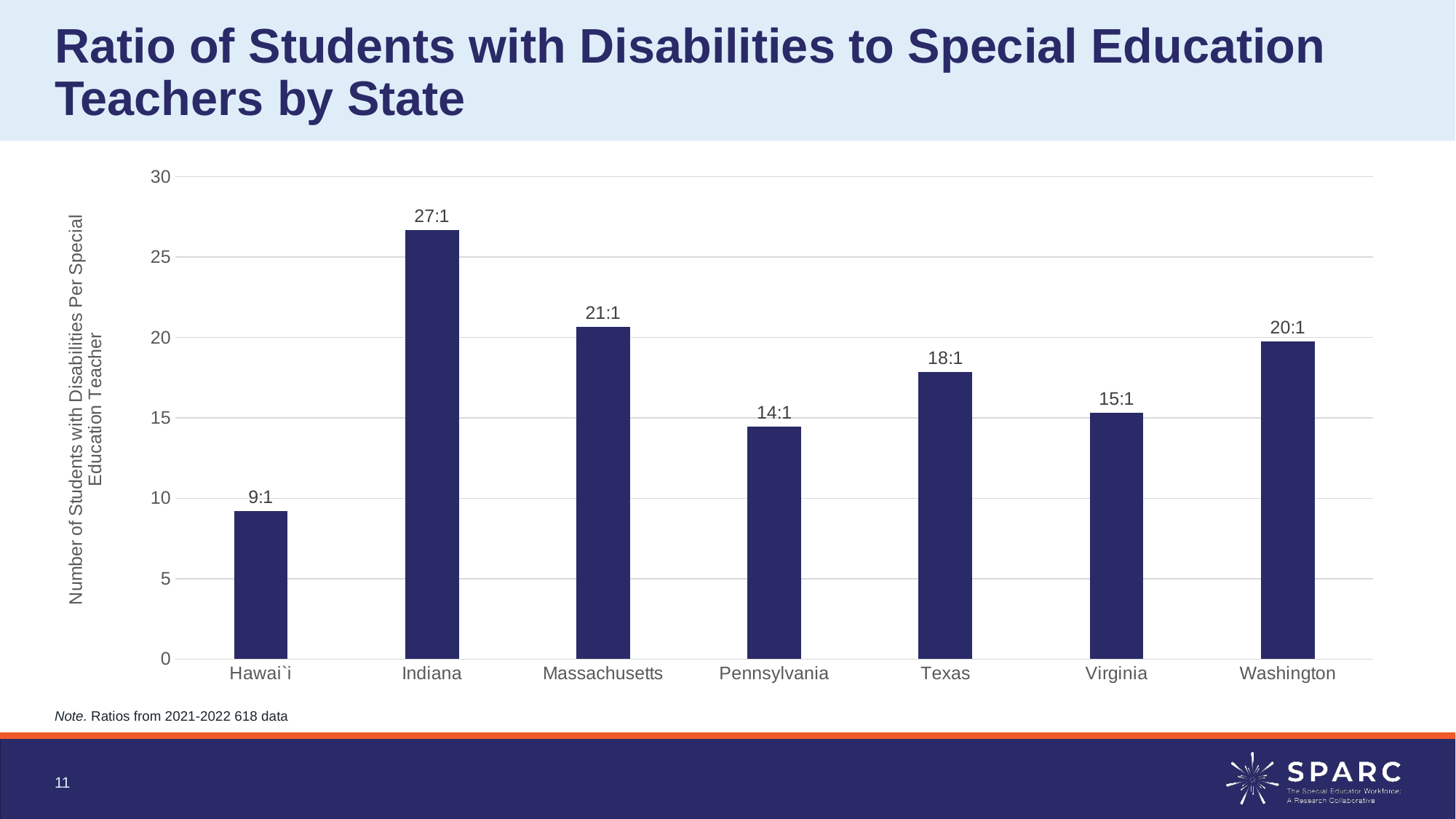
Which state has the highest ratio of students with disabilities to special education teachers? Indiana Is the value for Hawai`i greater or less than 10? less How many states are shown in the chart? 7 What is the ratio shown for Pennsylvania? 14:1 What kind of chart is shown on the slide? Bar chart Which state has a higher ratio, Texas or Virginia? Texas Which state has the lowest ratio of students with disabilities to special education teachers? Hawai`i What is the ratio shown for Texas? 18:1 What is the ratio shown for Indiana? 27:1 Which state has a higher ratio, Massachusetts or Pennsylvania? Massachusetts What is the ratio shown for Washington? 20:1 Is the value for Indiana greater or less than 25? greater